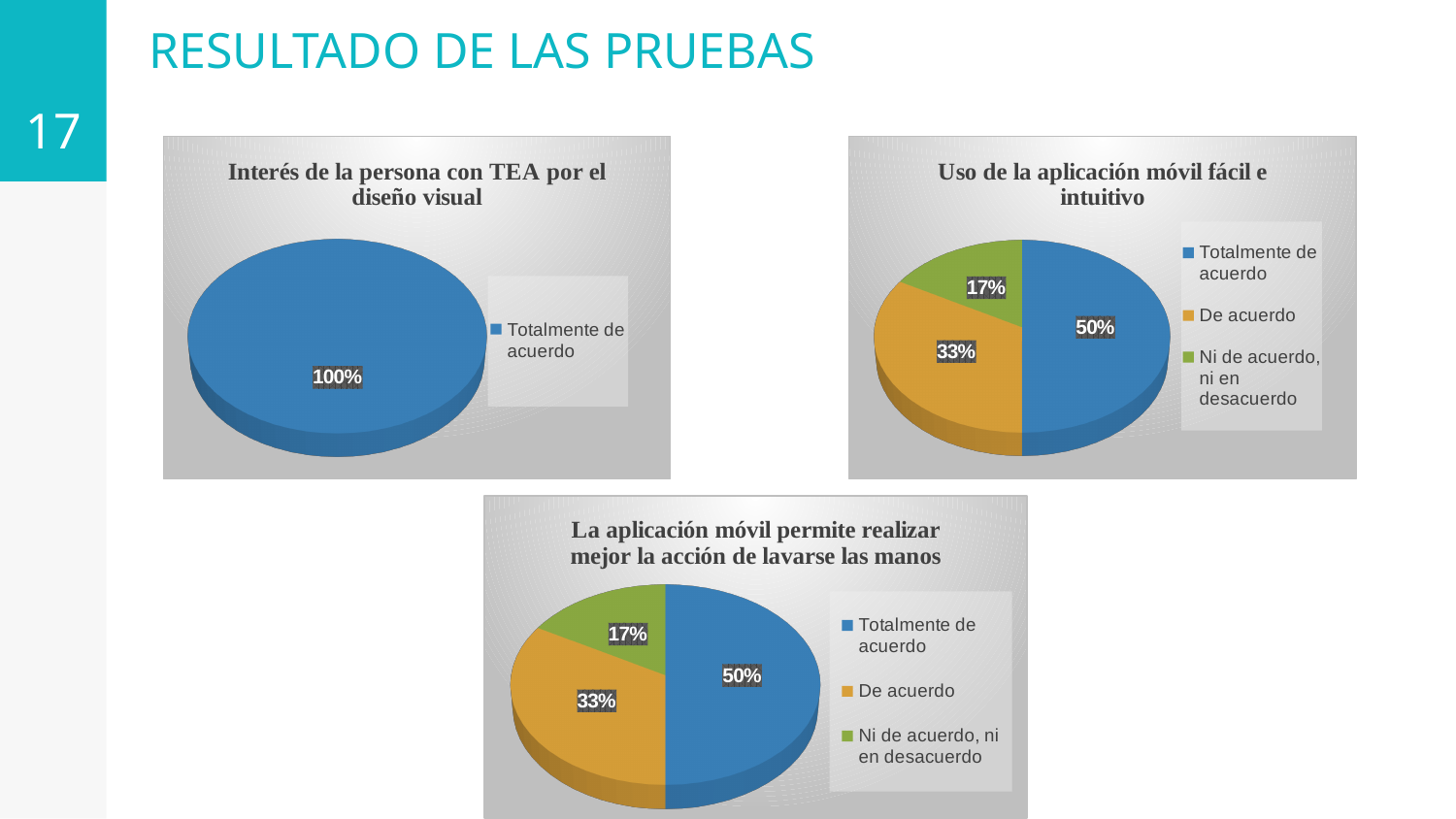
In the chart titled "La aplicación móvil permite realizar mejor la acción de lavarse las manos", what share does "Totalmente de acuerdo" have? 50% In the chart titled "Interés de la persona con TEA por el diseño visual", what share does "Totalmente de acuerdo" have? 100% In the chart titled "Uso de la aplicación móvil fácil e intuitivo", which category has the smallest slice? Ni de acuerdo, ni en desacuerdo In the chart titled "La aplicación móvil permite realizar mejor la acción de lavarse las manos", how many categories does the legend list? 3 In the chart titled "Interés de la persona con TEA por el diseño visual", how many categories does the legend list? 1 What kind of chart is "Uso de la aplicación móvil fácil e intuitivo"? Pie chart In the chart titled "La aplicación móvil permite realizar mejor la acción de lavarse las manos", what colour is the "De acuerdo" slice? Orange In the chart titled "Uso de la aplicación móvil fácil e intuitivo", what share does "Ni de acuerdo, ni en desacuerdo" have? 17% In the chart titled "Uso de la aplicación móvil fácil e intuitivo", which category has the largest slice? Totalmente de acuerdo In the chart titled "La aplicación móvil permite realizar mejor la acción de lavarse las manos", which is larger: "De acuerdo" or "Ni de acuerdo, ni en desacuerdo"? De acuerdo In the chart titled "Uso de la aplicación móvil fácil e intuitivo", what is the difference between the "Totalmente de acuerdo" and "De acuerdo" shares? 17%